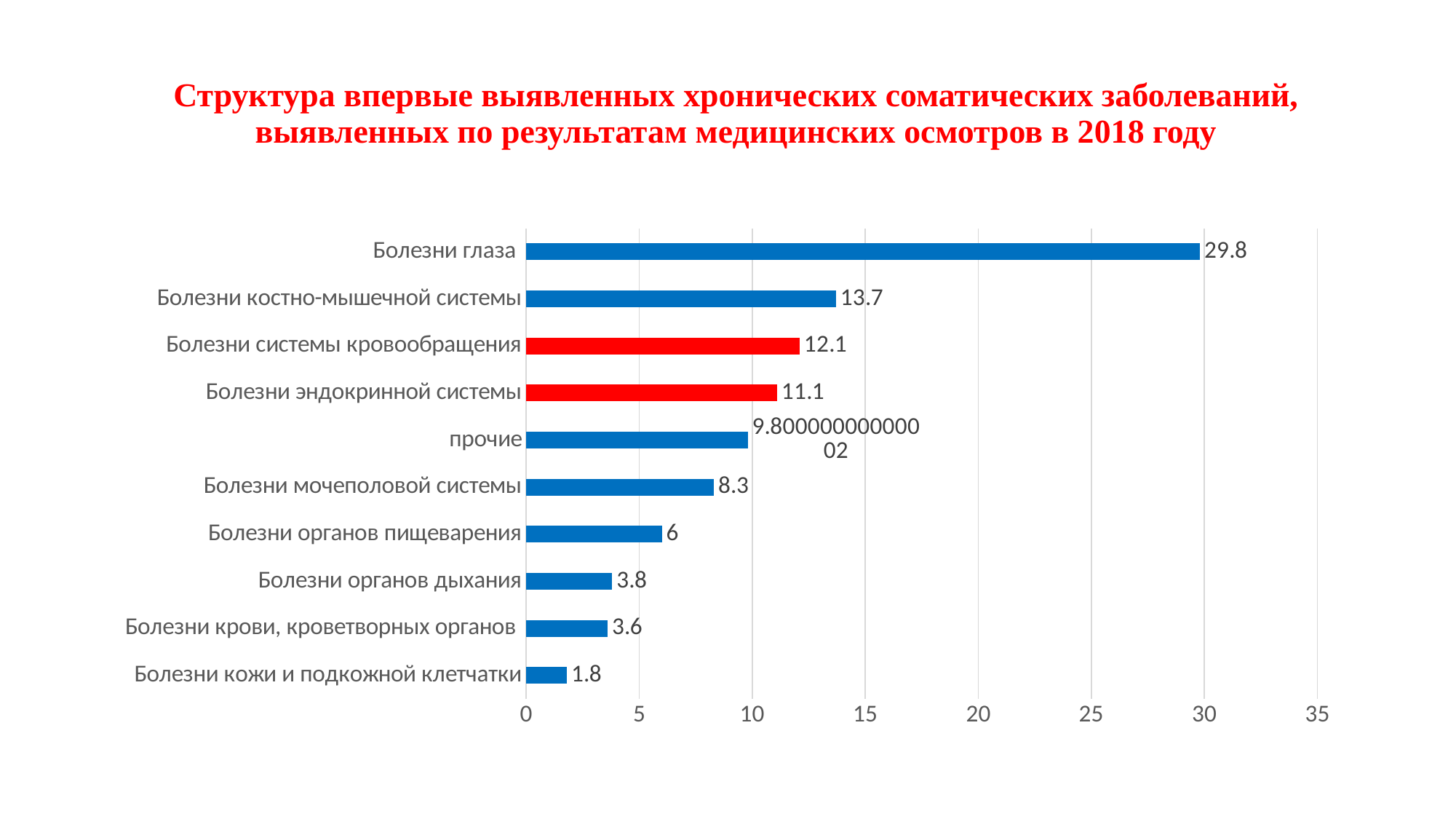
What is the value for Болезни костно-мышечной системы? 13.7 What is the difference between the values for Болезни глаза and Болезни костно-мышечной системы? 16.1 What is the value for Болезни глаза? 29.8 What is the value for Болезни кожи и подкожной клетчатки? 1.8 How many categories are shown in the chart? 10 Which category has the highest value? Болезни глаза Is the value for Болезни мочеполовой системы greater or less than 10? less Which two categories are shown with red bars? Болезни системы кровообращения and Болезни эндокринной системы What is the value for Болезни эндокринной системы? 11.1 Which category has the lowest value? Болезни кожи и подкожной клетчатки Which is larger, the value for Болезни системы кровообращения or Болезни эндокринной системы? Болезни системы кровообращения What kind of chart is shown on the slide? bar chart